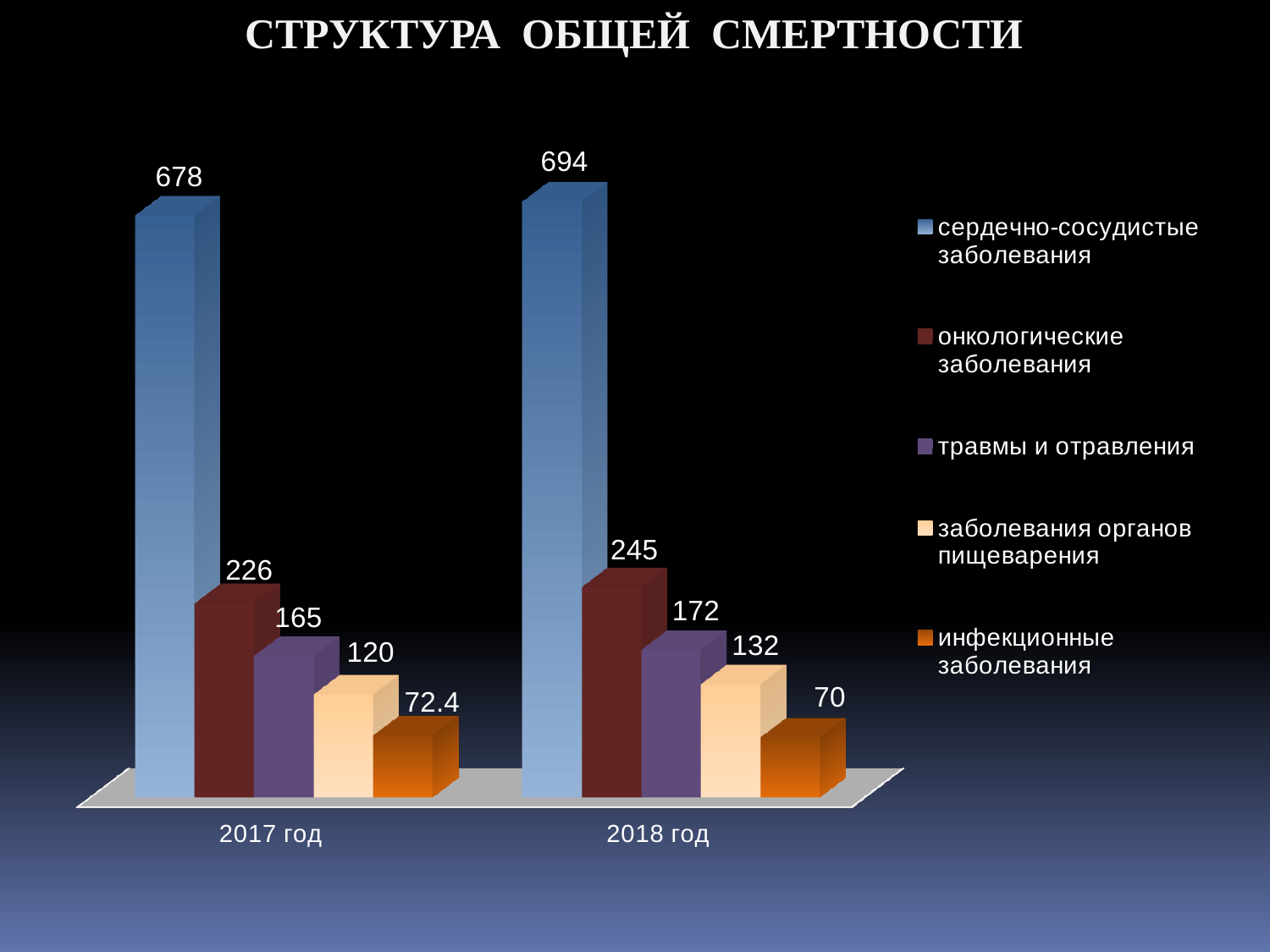
What is the value for онкологические заболевания in 2018 год? 245 Which series has the lowest value in 2017 год? инфекционные заболевания What is the difference between the values for сердечно-сосудистые заболевания in 2018 год and 2017 год? 16 What kind of chart is shown on the slide? bar chart Which series has the highest value in 2018 год? сердечно-сосудистые заболевания What is the value for заболевания органов пищеварения in 2018 год? 132 How many year categories are shown on the x axis? 2 How many series does the legend list? 5 What is the title of the slide? СТРУКТУРА ОБЩЕЙ СМЕРТНОСТИ What is the value for сердечно-сосудистые заболевания in 2017 год? 678 What is the value for инфекционные заболевания in 2017 год? 72.4 Which is larger: травмы и отравления in 2017 год or in 2018 год? 2018 год